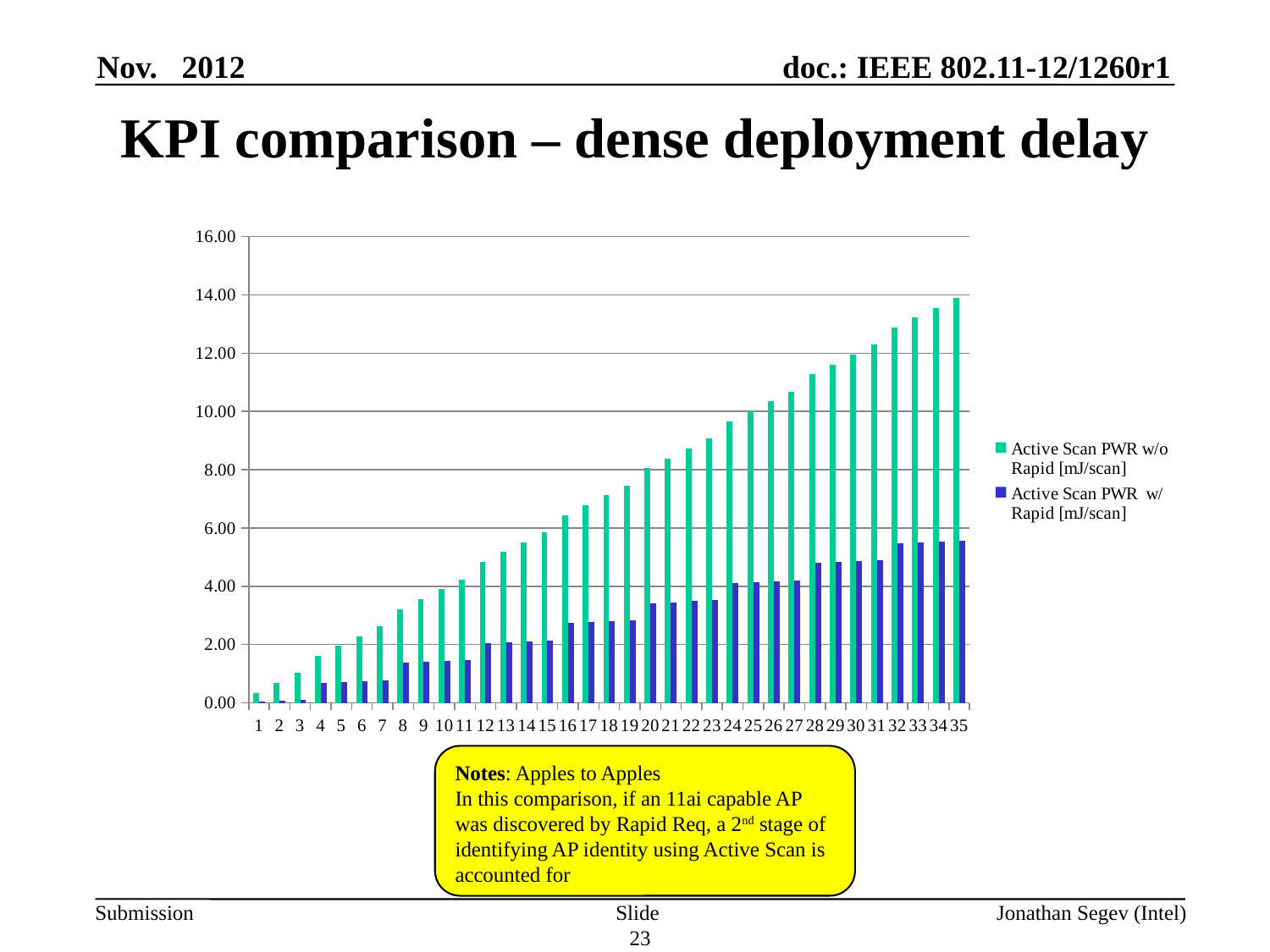
How many series does the legend list? 2 At category 20, which series has the larger value: Active Scan PWR w/o Rapid or Active Scan PWR w/ Rapid? Active Scan PWR w/o Rapid [mJ/scan] Which colour represents the Active Scan PWR w/ Rapid [mJ/scan] series? blue Is the value for Active Scan PWR w/ Rapid [mJ/scan] at category 10 greater or less than 2.00? less Do the values for Active Scan PWR w/o Rapid [mJ/scan] rise or fall as the category number increases? rise Is the value for Active Scan PWR w/ Rapid [mJ/scan] at category 35 greater or less than 4.00? greater Which category has the highest value for Active Scan PWR w/o Rapid [mJ/scan]? 35 Which category has the lowest value for Active Scan PWR w/o Rapid [mJ/scan]? 1 How many categories are shown along the x axis? 35 Is the value for Active Scan PWR w/o Rapid [mJ/scan] at category 15 greater or less than 8.00? less What kind of chart is shown on the slide? bar chart